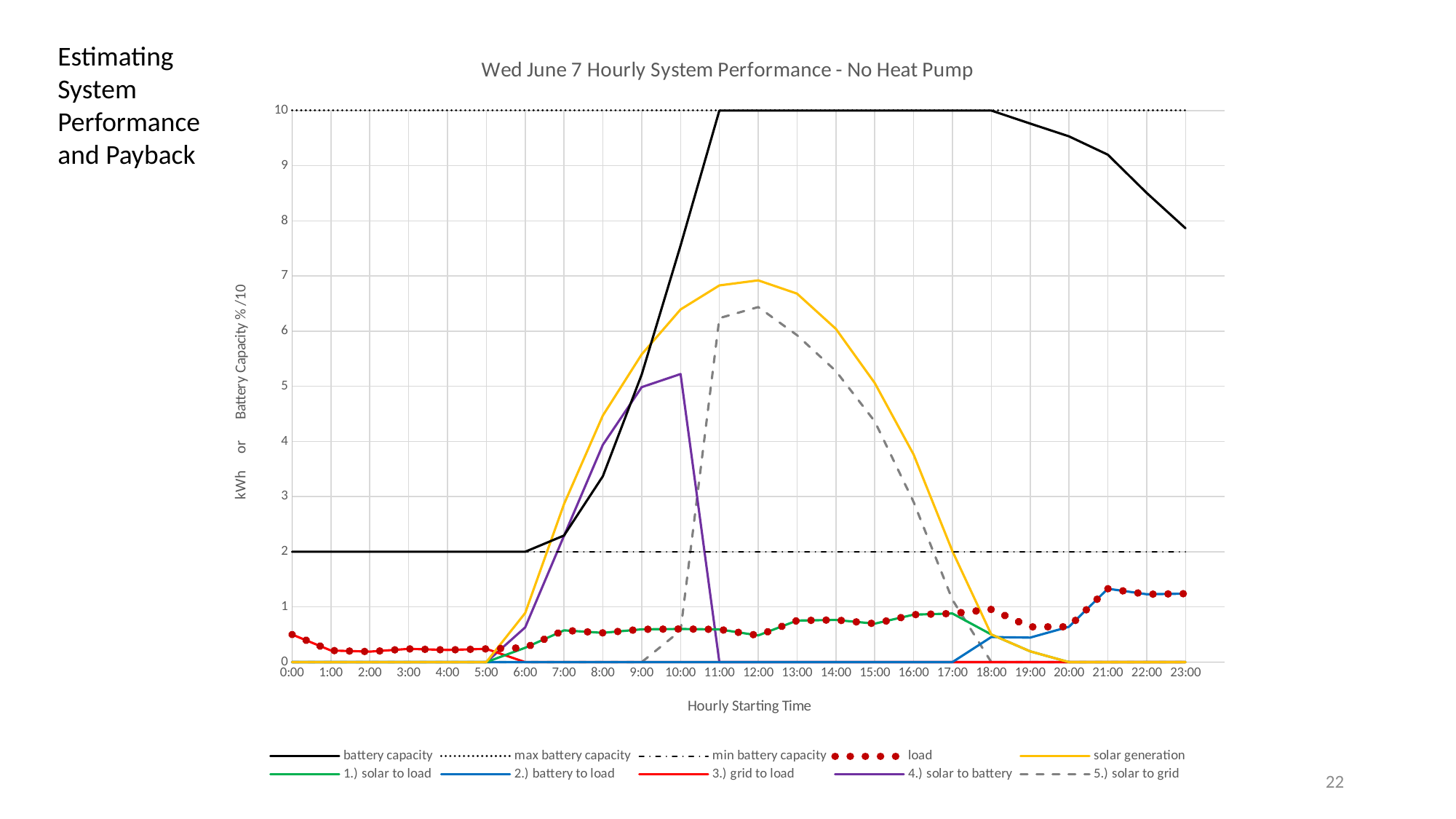
What is the battery capacity value at 12:00? 10 Does the battery capacity rise or fall from 18:00 to 23:00? fall What is the solar generation value at 0:00? 0 How many series does the legend list? 10 What kind of chart is shown on the slide? line chart Which is larger at 9:00: solar generation or solar to battery? solar generation Is the battery capacity value at 23:00 greater or less than 7? greater Is the solar generation value at 12:00 greater or less than 6? greater What value does the min battery capacity line sit at? 2 What value does the max battery capacity line sit at? 10 How many hourly points are plotted along the x axis? 24 Is the load value at 2:00 greater or less than 1? less